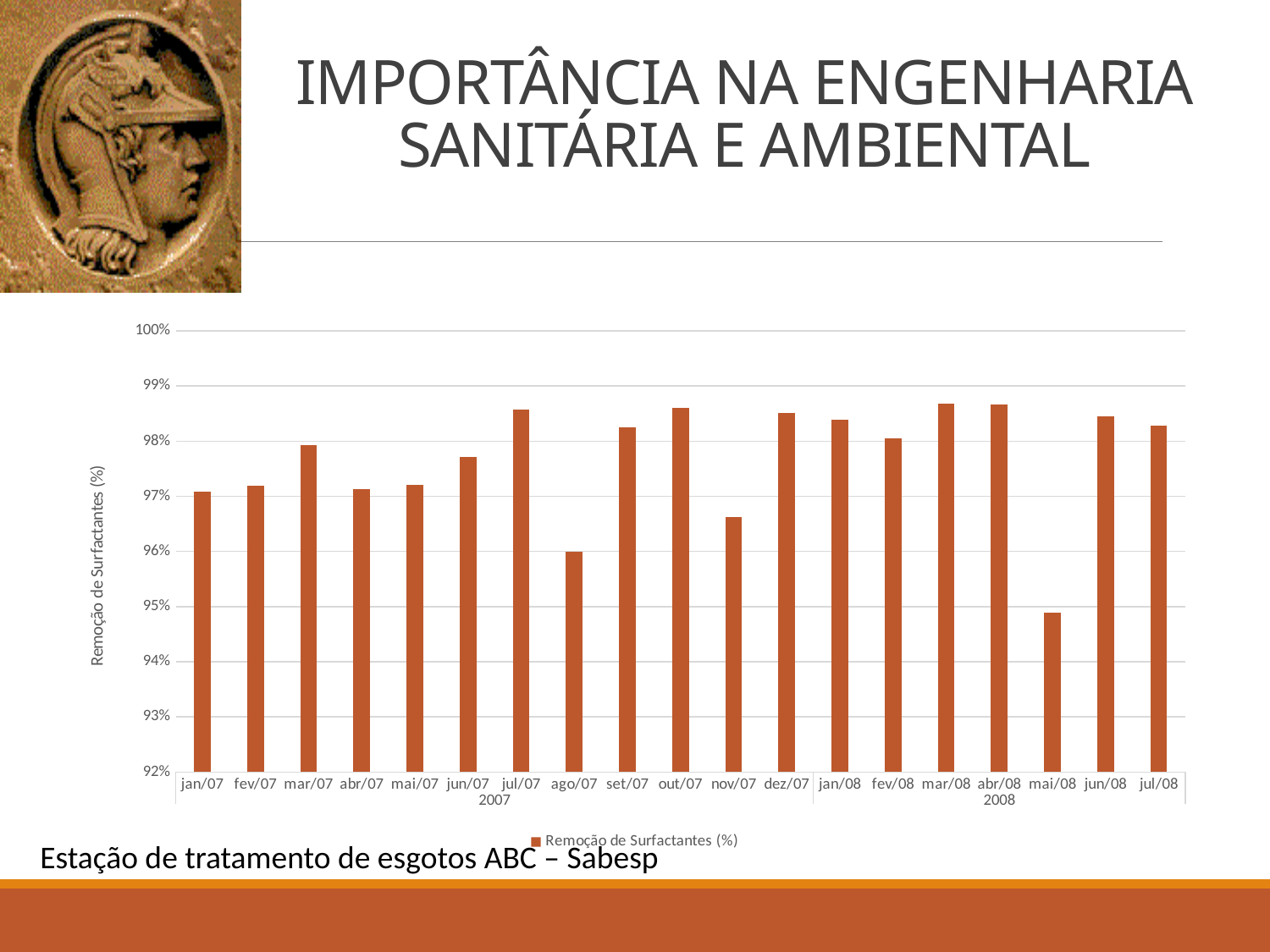
Which month has the lowest surfactant removal value? mai/08 Is the value for mai/08 greater or less than 95%? less Which is larger, the value for ago/07 or the value for set/07? set/07 How many series does the chart legend list? 1 What kind of chart is shown on the slide? bar chart Is the value for nov/07 greater or less than 97%? less What is the label of the vertical axis? Remoção de Surfactantes (%) Is the value for jul/07 greater or less than 98%? greater What series name appears in the chart legend? Remoção de Surfactantes (%) Which is larger, the value for mai/08 or the value for jun/08? jun/08 How many months (bars) are plotted in the chart? 19